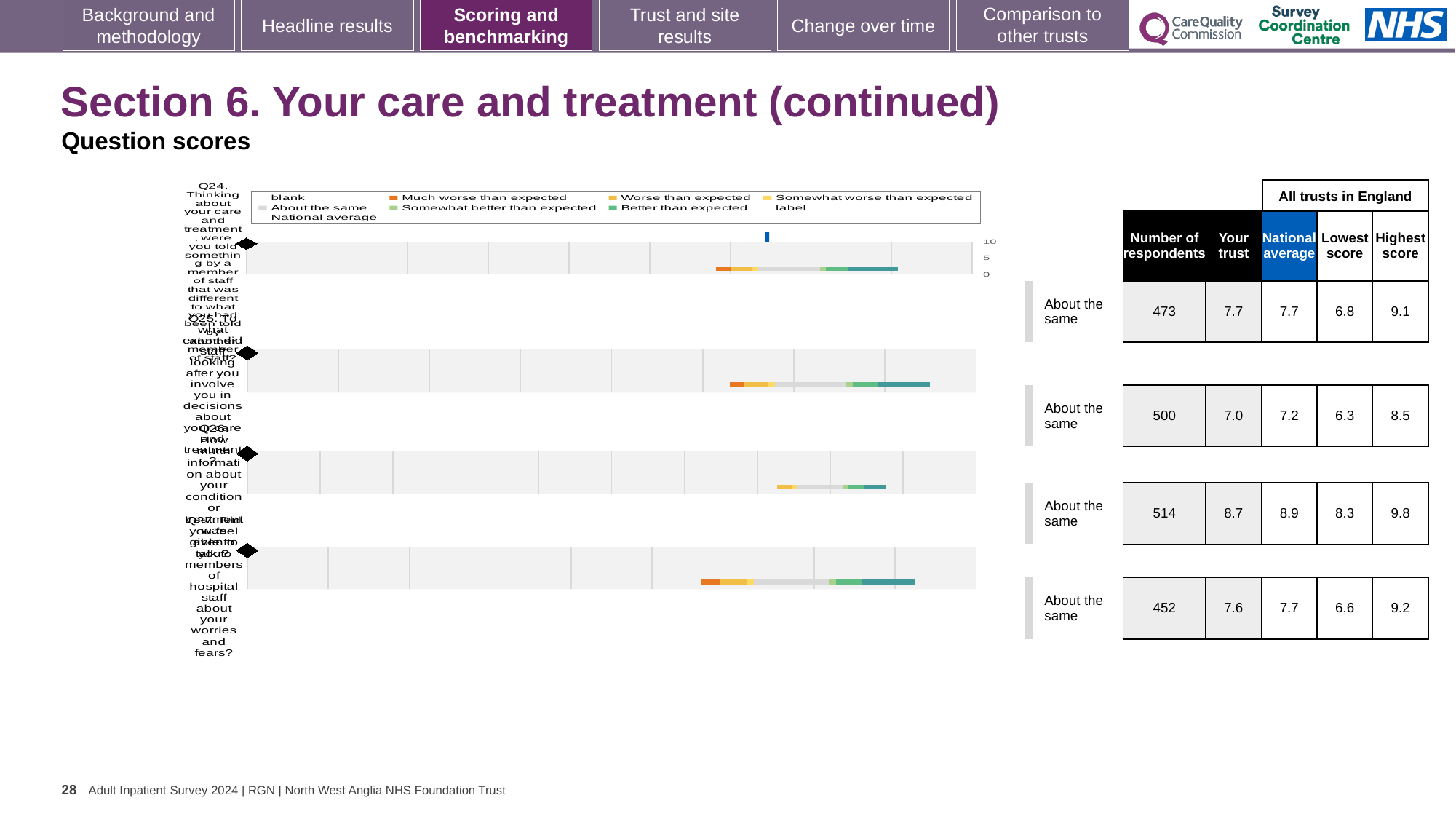
Which question has the lowest number of respondents? Q27 What is the 'Your trust' score for Q26? 8.7 What benchmark category is shown for all four questions in the chart? About the same Which has the larger 'Your trust' score, Q24 or Q25? Q24 What is the maximum value shown on the chart's score axis? 10 What is the lowest score across all trusts in England for Q25? 6.3 What kind of chart is used to show the question scores on this slide? bar chart How many respondents are listed for Q25? 500 How many questions (rows) are plotted in the chart? 4 What is the national average score for Q27? 7.7 Which question has the highest 'Your trust' score? Q26 What is the difference between the highest score and the lowest score for Q26? 1.5